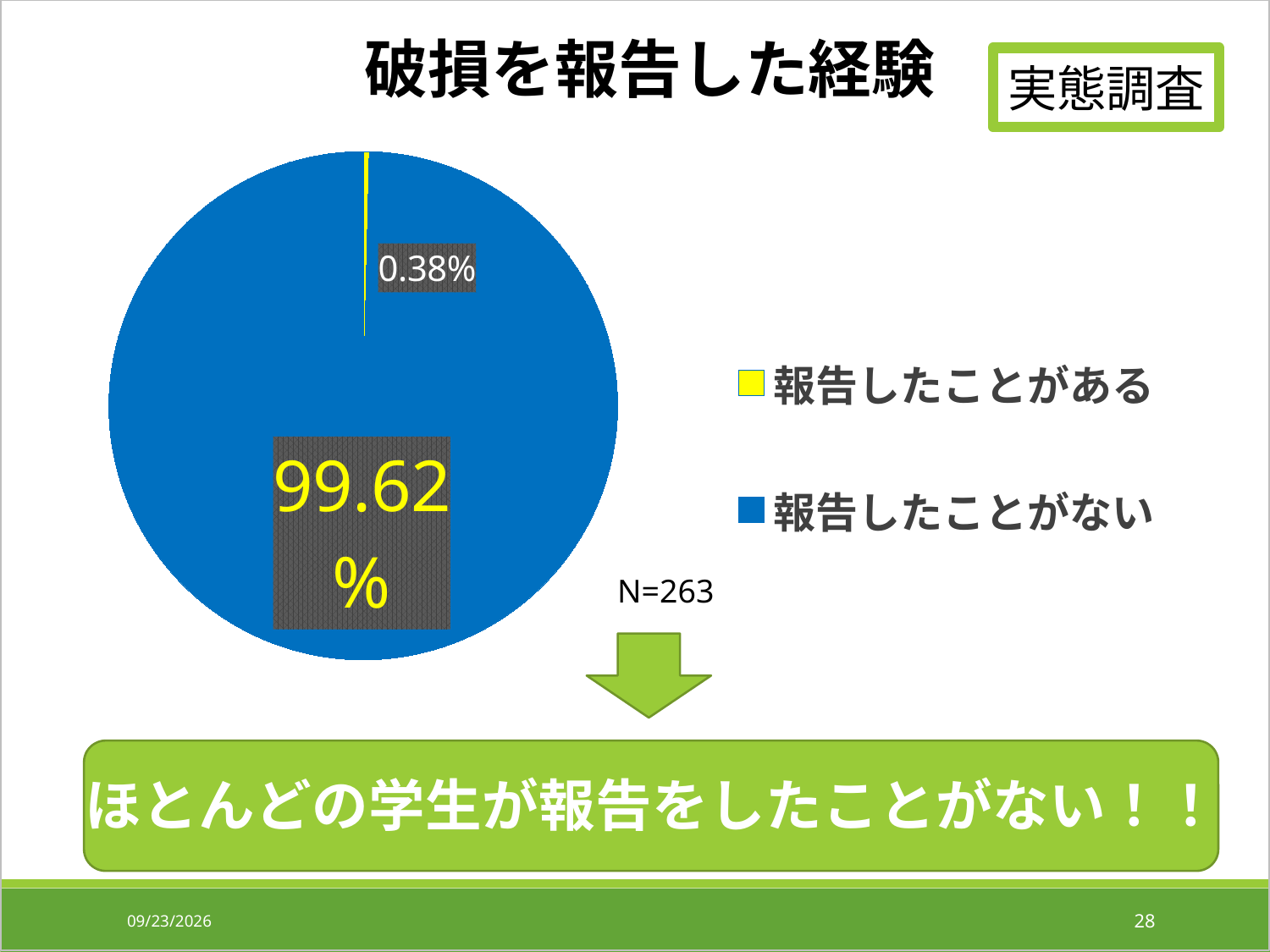
What type of chart is shown on the slide? pie chart What colour is the slice for 報告したことがない? blue What share of the pie does 報告したことがある take? 0.38% Which is larger, the slice for 報告したことがある or the slice for 報告したことがない? 報告したことがない What is the difference in percentage points between the 報告したことがない slice and the 報告したことがある slice? 99.24 What share of the pie does 報告したことがない take? 99.62% What is the title of the chart on the slide? 破損を報告した経験 How many categories does the pie chart have? 2 What is the sample size (N) shown next to the chart? N=263 Which category has the largest slice of the pie? 報告したことがない Which category has the smallest slice of the pie? 報告したことがある How many entries does the legend list? 2